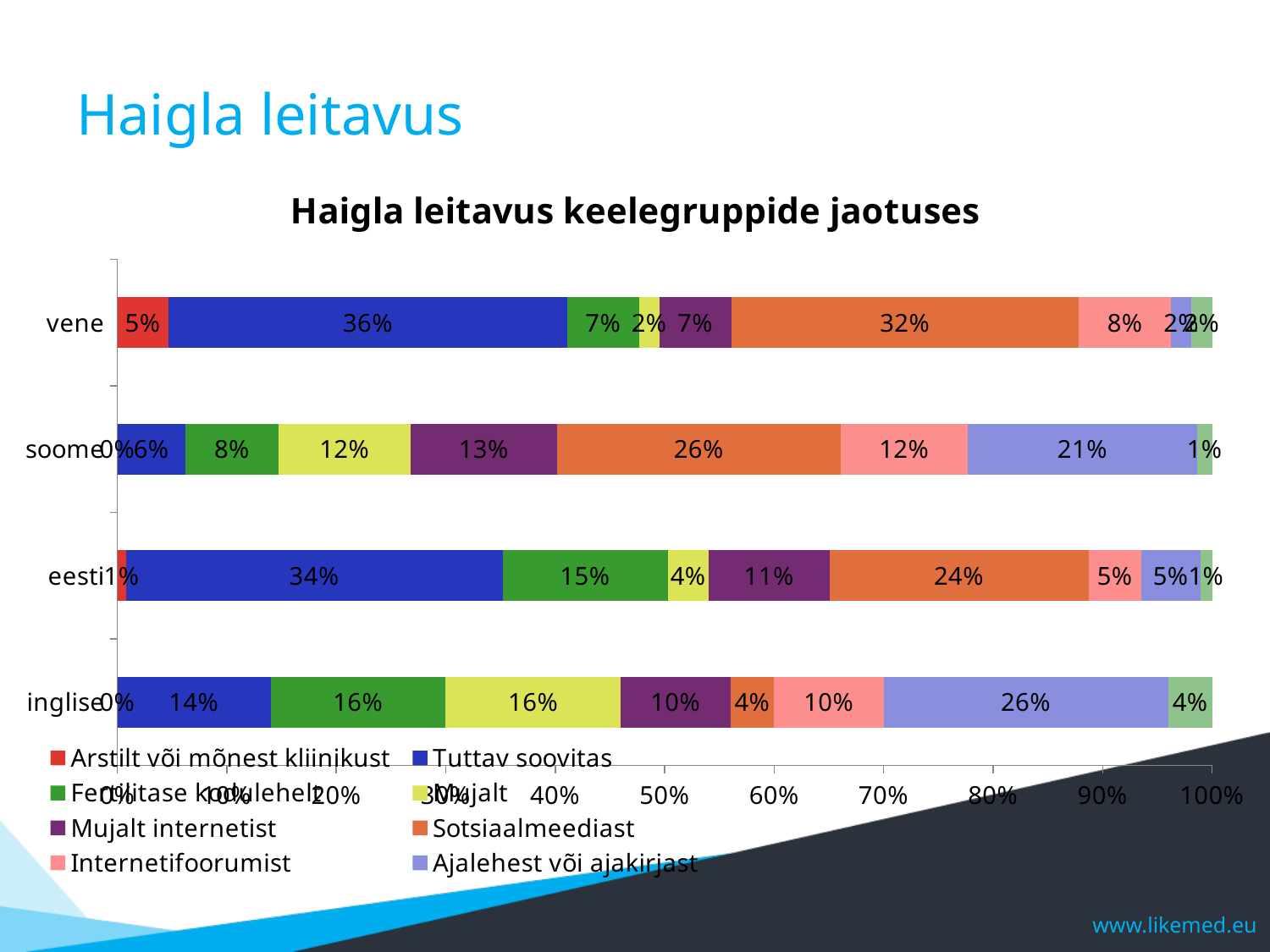
What is the value for Fertilitase kodulehelt in the eesti bar? 15% Which is larger: the Mujalt internetist value for soome or for eesti? soome What type of chart is shown on the slide? Stacked bar chart Which language group has the lowest value for Tuttav soovitas? soome How many language groups are shown on the chart? 4 What is the value for Ajalehest või ajakirjast in the inglise bar? 26% What is the value for Sotsiaalmeediast in the soome bar? 26% What is the value for Mujalt internetist in the soome bar? 13% Which language group has the highest value for Sotsiaalmeediast? vene What is the difference in percentage points between the Sotsiaalmeediast values for vene and eesti? 8 Which language group has the highest value for Ajalehest või ajakirjast? inglise What is the value for Tuttav soovitas in the vene bar? 36%